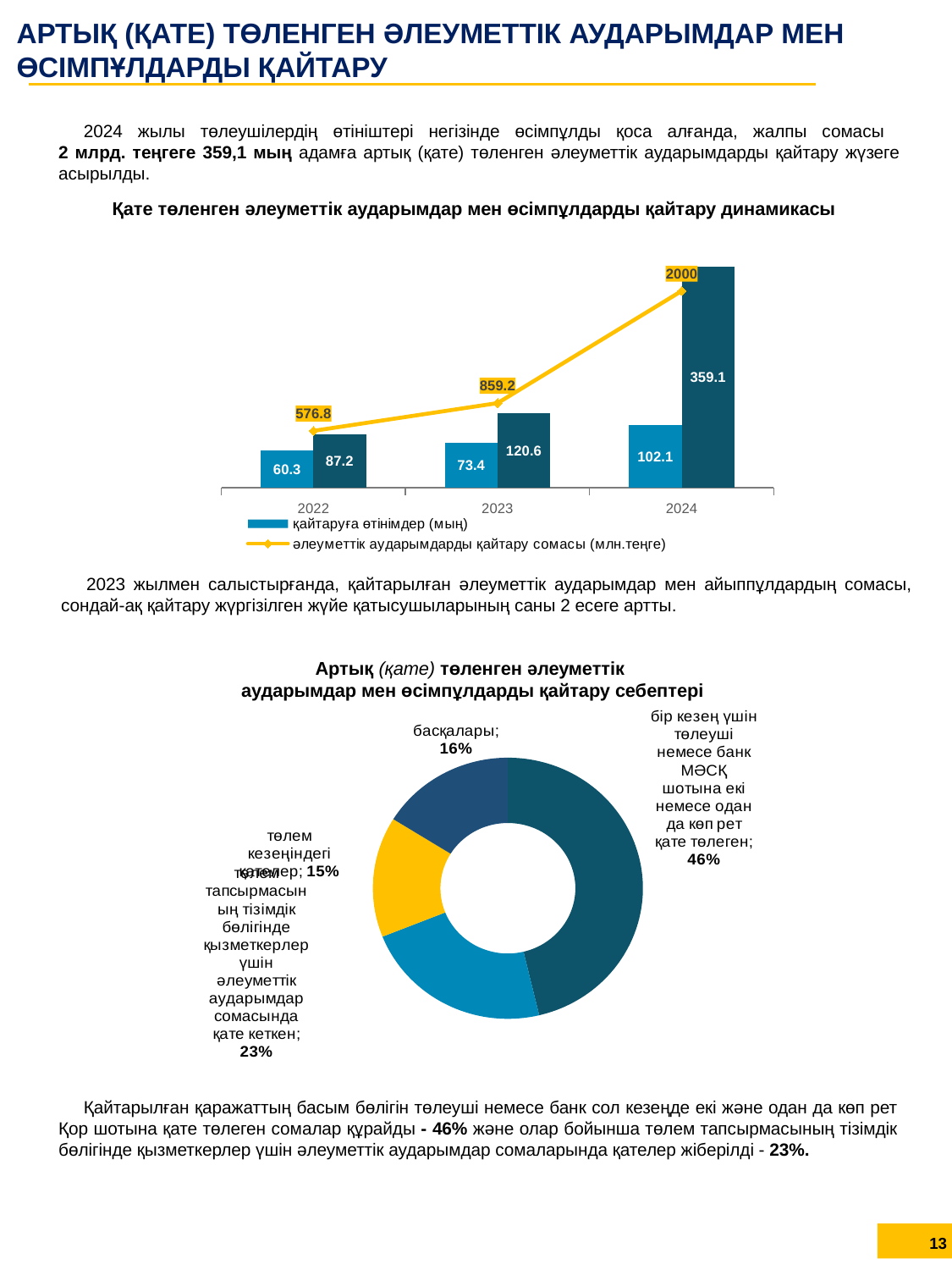
In the chart 'Қате төленген әлеуметтік аударымдар мен өсімпұлдарды қайтару динамикасы', what is the value of the light blue bar 'қайтаруға өтінімдер (мың)' for 2023? 73.4 In the chart 'Қате төленген әлеуметтік аударымдар мен өсімпұлдарды қайтару динамикасы', does the line series rise or fall from 2022 to 2024? rise In the chart 'Қате төленген әлеуметтік аударымдар мен өсімпұлдарды қайтару динамикасы', which year has the lowest value for 'қайтаруға өтінімдер (мың)'? 2022 In the doughnut chart 'Артық (қате) төленген әлеуметтік аударымдар мен өсімпұлдарды қайтару себептері', which category has the largest share? бір кезең үшін төлеуші немесе банк МӘСҚ шотына екі немесе одан да көп рет қате төлеген In the chart 'Қате төленген әлеуметтік аударымдар мен өсімпұлдарды қайтару динамикасы', what is the difference between the line values for 2023 and 2022? 282.4 In the doughnut chart 'Артық (қате) төленген әлеуметтік аударымдар мен өсімпұлдарды қайтару себептері', what share does 'басқалары' have? 16% In the chart 'Қате төленген әлеуметтік аударымдар мен өсімпұлдарды қайтару динамикасы', what is the value of the line series 'әлеуметтік аударымдарды қайтару сомасы (млн.теңге)' for 2024? 2000 What type of chart is 'Артық (қате) төленген әлеуметтік аударымдар мен өсімпұлдарды қайтару себептері'? doughnut chart In the chart 'Қате төленген әлеуметтік аударымдар мен өсімпұлдарды қайтару динамикасы', what is the value of the dark blue bar for 2024? 359.1 How many years are shown on the x axis of the chart 'Қате төленген әлеуметтік аударымдар мен өсімпұлдарды қайтару динамикасы'? 3 In the doughnut chart 'Артық (қате) төленген әлеуметтік аударымдар мен өсімпұлдарды қайтару себептері', which is larger: 'төлем кезеңіндегі қателер' or 'басқалары'? басқалары How many entries does the legend of the chart 'Қате төленген әлеуметтік аударымдар мен өсімпұлдарды қайтару динамикасы' list? 2